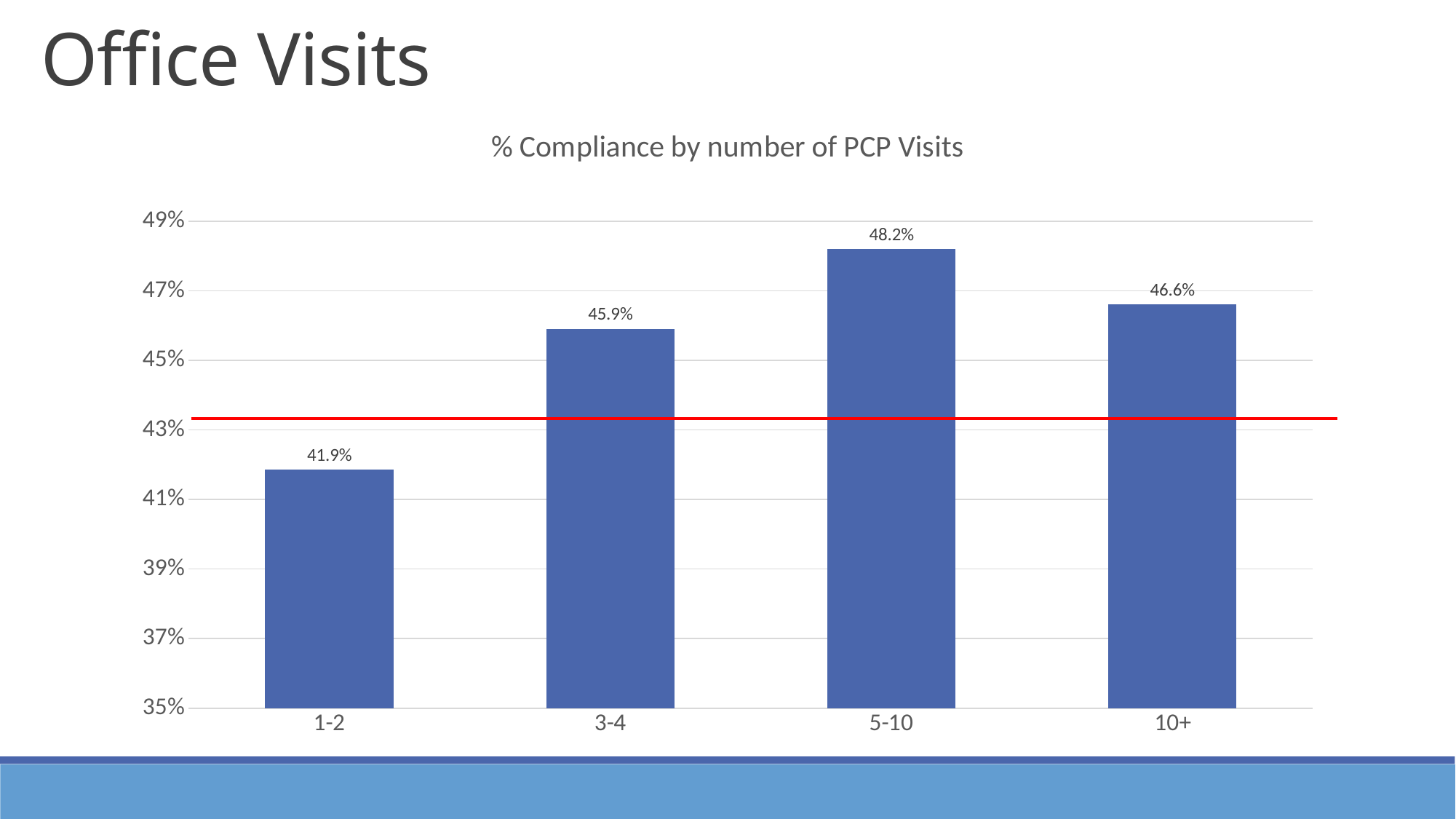
What is the % compliance for the 1-2 PCP visits category? 41.9% What is the difference in % compliance between the 5-10 and 1-2 categories? 6.3% What kind of chart is shown on the slide? bar chart Which has a higher % compliance, 3-4 visits or 10+ visits? 10+ What is the title of the chart? % Compliance by number of PCP Visits What is the % compliance for the 5-10 PCP visits category? 48.2% How many categories are shown on the x axis? 4 Which category has the lowest % compliance? 1-2 Is the value for the 1-2 category greater or less than 43%? less Which category has the highest % compliance? 5-10 What is the % compliance for the 10+ PCP visits category? 46.6% What is the % compliance for the 3-4 PCP visits category? 45.9%